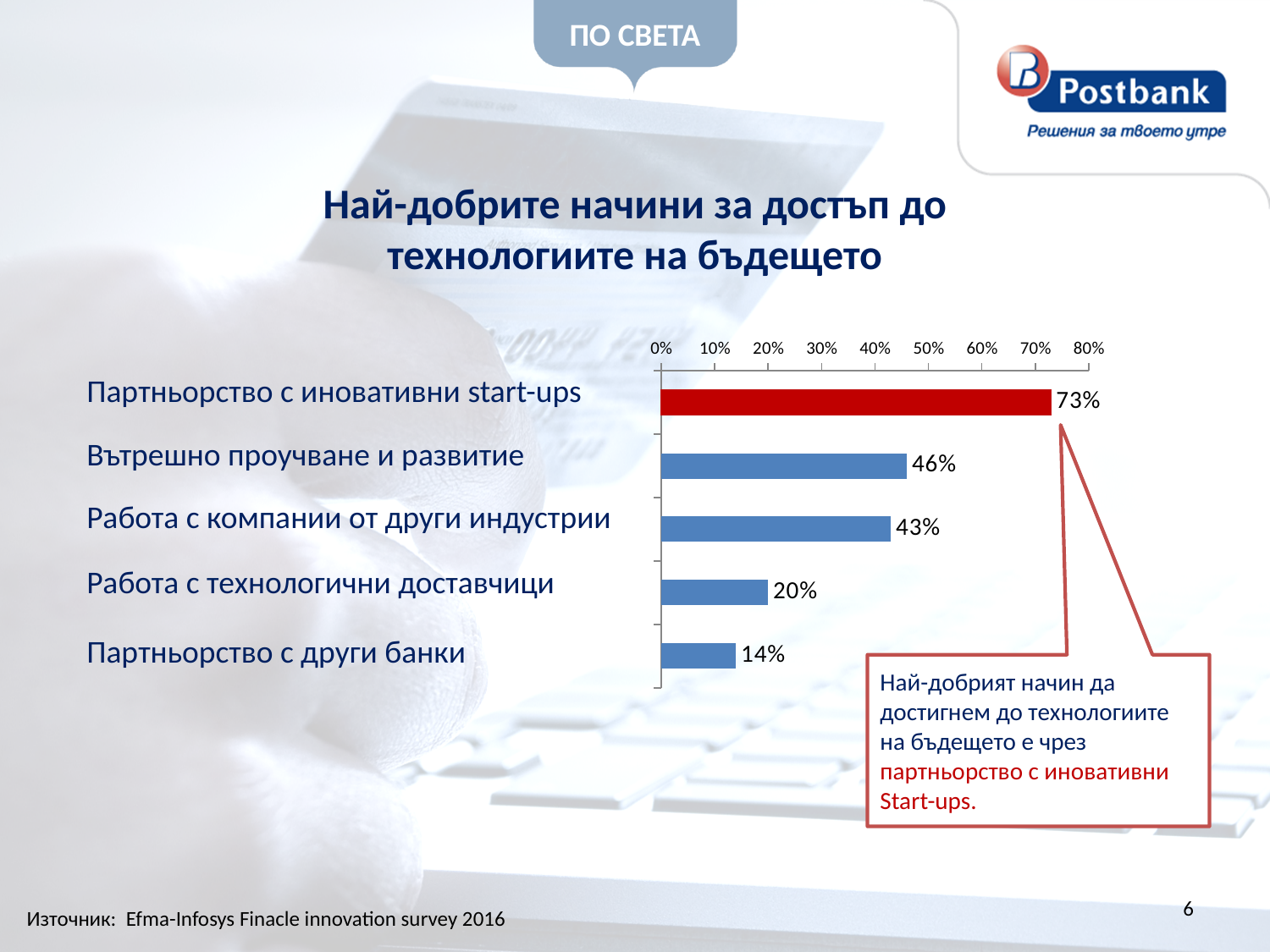
What is the difference between the values for Партньорство с иновативни start-ups and Вътрешно проучване и развитие? 27% What is the value for Работа с компании от други индустрии? 43% How many categories are shown in the chart? 5 Which bar is coloured red rather than blue? Партньорство с иновативни start-ups What is the value for Работа с технологични доставчици? 20% Which is larger: the value for Работа с технологични доставчици or the value for Партньорство с други банки? Работа с технологични доставчици What kind of chart is shown on the slide? Bar chart What is the value for Вътрешно проучване и развитие? 46% What is the value for Партньорство с иновативни start-ups? 73% What is the value for Партньорство с други банки? 14% Which category has the highest value? Партньорство с иновативни start-ups Which category has the lowest value? Партньорство с други банки